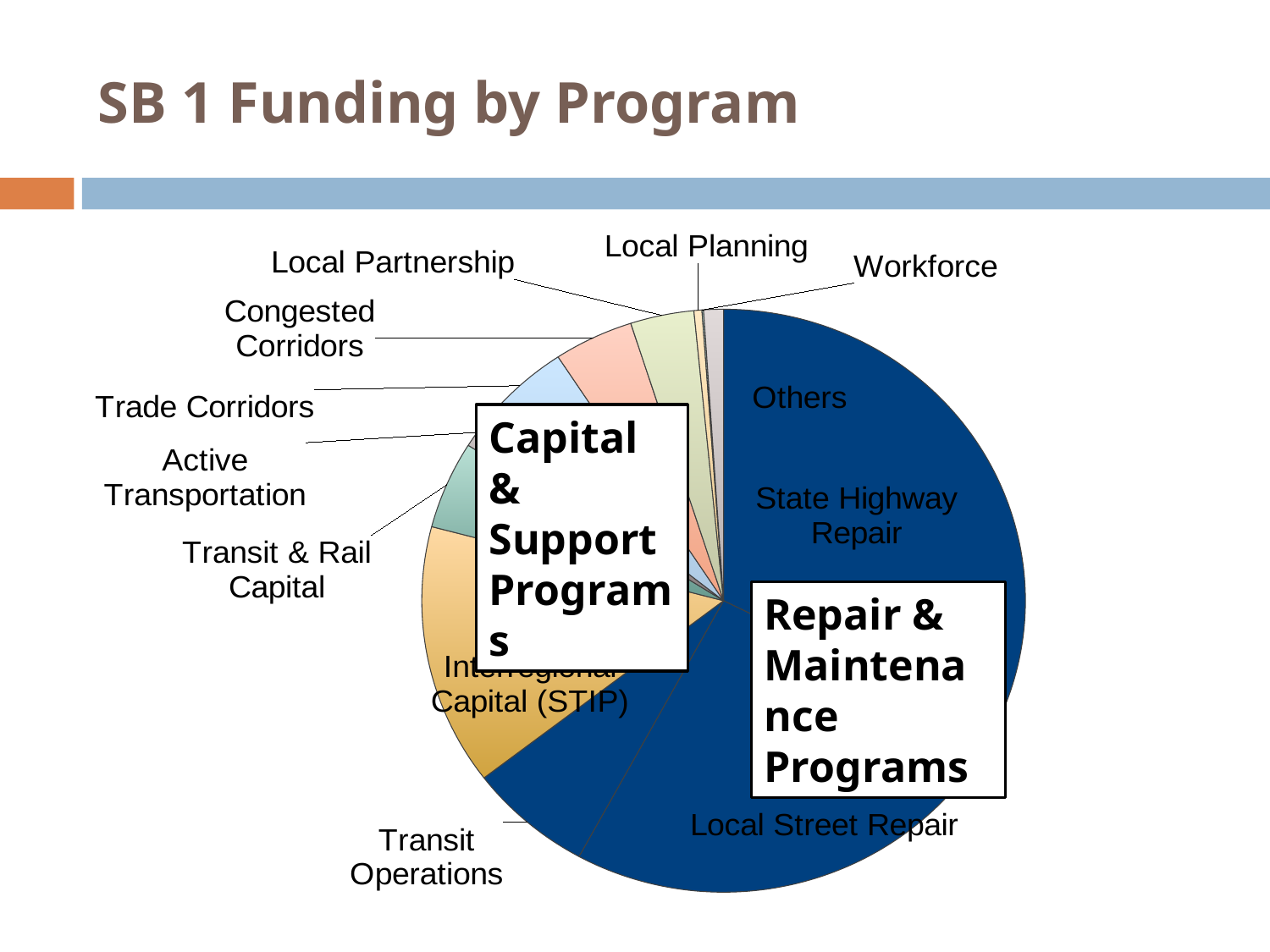
How many labeled slices does the pie chart have? 12 What are the two program groupings labeled in the boxes overlaid on the pie chart? Capital & Support Programs; Repair & Maintenance Programs What is the title of the slide containing the pie chart? SB 1 Funding by Program Which slice is larger, State Highway Repair or Congested Corridors? State Highway Repair Which slice is larger, Transit & Rail Capital or Workforce? Transit & Rail Capital Which slice is larger, Interregional Capital (STIP) or Local Planning? Interregional Capital (STIP) What kind of chart is shown on the slide? Pie chart